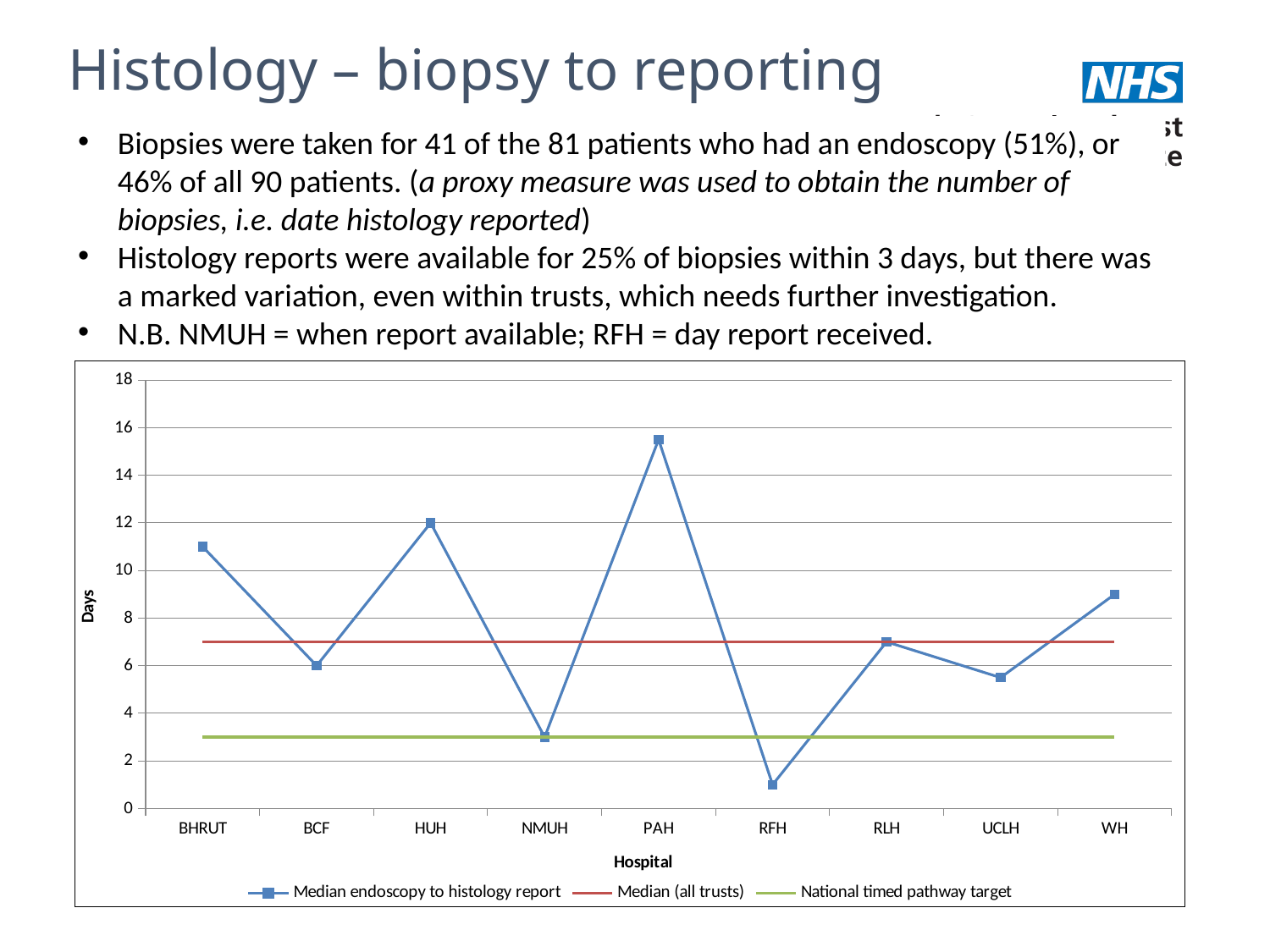
What is the median endoscopy to histology report value for HUH, in days? 12 Is the median endoscopy to histology report value for RFH greater or less than 2 days? less Which hospital has the lowest median endoscopy to histology report time? RFH What is the median endoscopy to histology report value for BCF, in days? 6 What kind of chart is shown on the slide? Line chart Which has a larger median endoscopy to histology report value, BHRUT or UCLH? BHRUT Is the median endoscopy to histology report value for PAH greater or less than 14 days? greater How many hospitals are shown on the x axis of the chart? 9 What is the title of the y axis of the chart? Days Which hospital has the highest median endoscopy to histology report time? PAH What is the difference in days between the median endoscopy to histology report values for HUH and BCF? 6 How many series does the chart legend list? 3